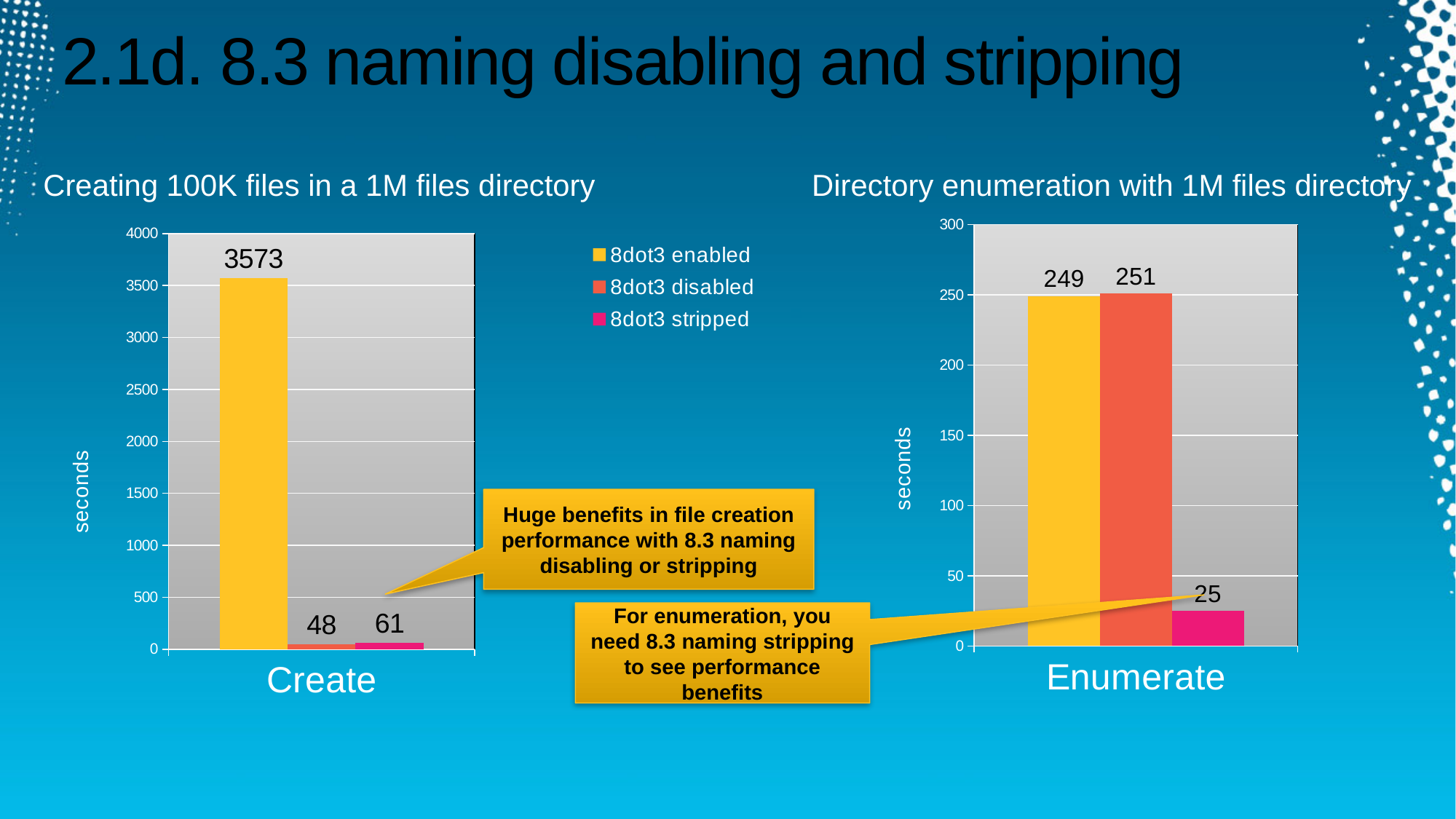
In the 'Creating 100K files in a 1M files directory' chart, what is the difference between the 8dot3 enabled and 8dot3 disabled values? 3525 In the 'Creating 100K files in a 1M files directory' chart, what is the value for 8dot3 disabled? 48 In the 'Creating 100K files in a 1M files directory' chart, which series has the highest value? 8dot3 enabled What type of chart is the 'Directory enumeration with 1M files directory' chart? Bar chart In the 'Creating 100K files in a 1M files directory' chart, what is the value for 8dot3 stripped? 61 In the 'Directory enumeration with 1M files directory' chart, what is the value for 8dot3 stripped? 25 In the 'Directory enumeration with 1M files directory' chart, what is the value for 8dot3 enabled? 249 In the 'Creating 100K files in a 1M files directory' chart, what is the value for 8dot3 enabled? 3573 In the 'Directory enumeration with 1M files directory' chart, what is the difference between the 8dot3 disabled and 8dot3 stripped values? 226 In the 'Directory enumeration with 1M files directory' chart, which series has the lowest value? 8dot3 stripped In the 'Creating 100K files in a 1M files directory' chart, which is larger: the value for 8dot3 disabled or 8dot3 stripped? 8dot3 stripped How many series does the legend list? 3